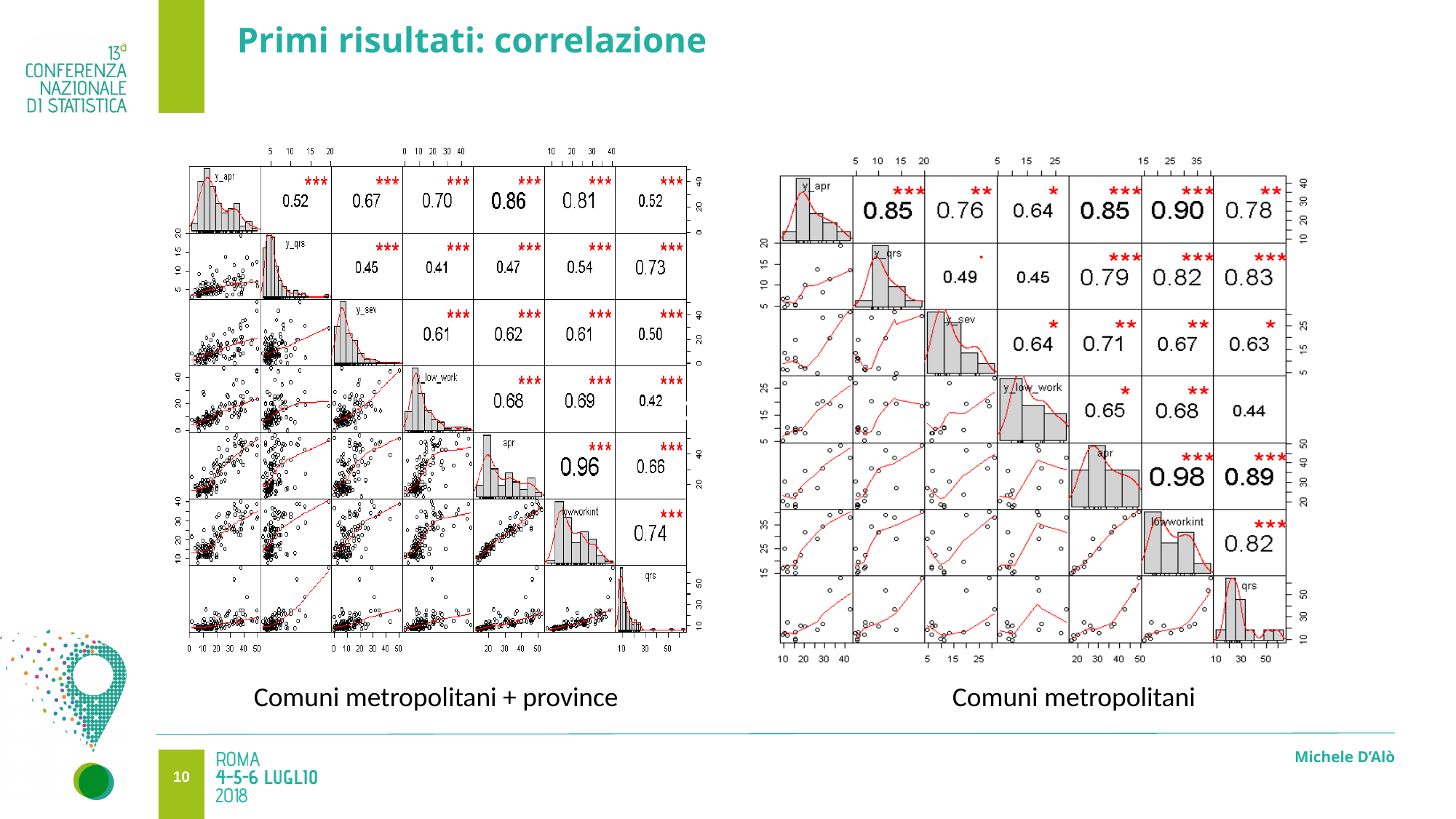
In the left chart (Comuni metropolitani + province), which pair of variables has the lowest correlation coefficient? y_qrs and y_low_work (0.41) How many variables are included in each correlation matrix on the slide? 7 In the right chart (Comuni metropolitani), what is the correlation between apr and lowworkint? 0.98 In the right chart (Comuni metropolitani), what is the correlation between y_low_work and qrs? 0.44 Is the correlation between y_apr and y_qrs higher in the left chart (Comuni metropolitani + province) or in the right chart (Comuni metropolitani)? Right chart (Comuni metropolitani) In the left chart (Comuni metropolitani + province), which pair of variables has the highest correlation coefficient? apr and lowworkint (0.96) In the left chart (Comuni metropolitani + province), what is the correlation between y_apr and apr? 0.86 What is the difference between the y_apr–y_qrs correlation in the right chart (0.85) and in the left chart (0.52)? 0.33 What kind of chart is shown on each side of the slide? Scatterplot (correlation) matrix with histograms on the diagonal In the right chart (Comuni metropolitani), what is the correlation between y_apr and lowworkint? 0.90 In the left chart (Comuni metropolitani + province), what is the correlation between apr and lowworkint? 0.96 In the left chart (Comuni metropolitani + province), what is the correlation between y_qrs and qrs? 0.73